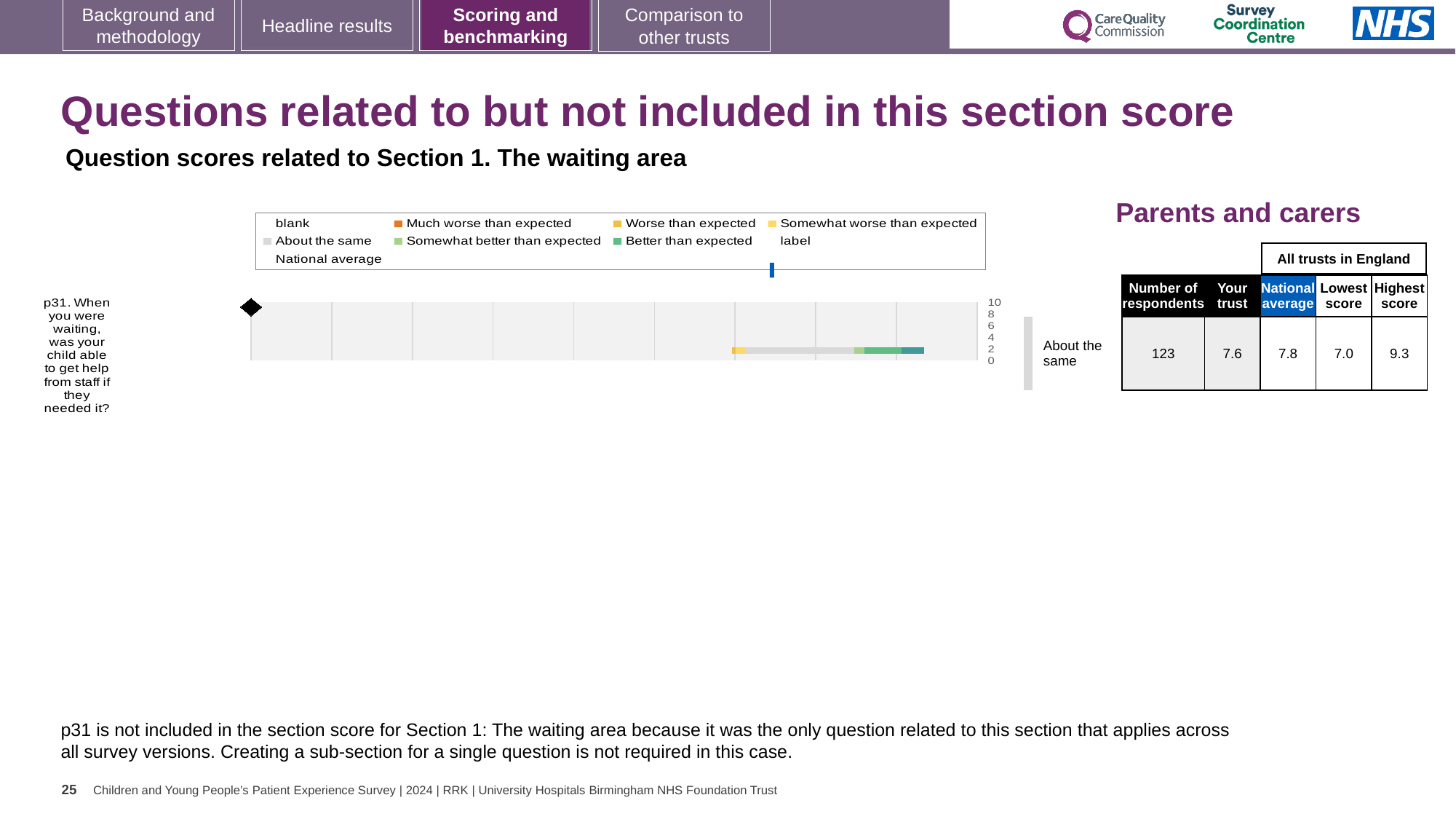
What is the national average score for p31? 7.8 Which is larger for p31, the 'Your trust' score or the national average? National average What is the difference between the highest and lowest scores across all trusts in England for p31? 2.3 Which benchmark category is the trust's result for p31 labelled as? About the same What is the highest score across all trusts in England for p31? 9.3 What is the 'Your trust' score for p31? 7.6 What is the lowest score across all trusts in England for p31? 7.0 What is the difference between the national average and the 'Your trust' score for p31? 0.2 What kind of chart is used to show the p31 question score? bar chart How many respondents answered p31? 123 How many questions are plotted in the chart? 1 Which question is plotted in the chart? p31. When you were waiting, was your child able to get help from staff if they needed it?